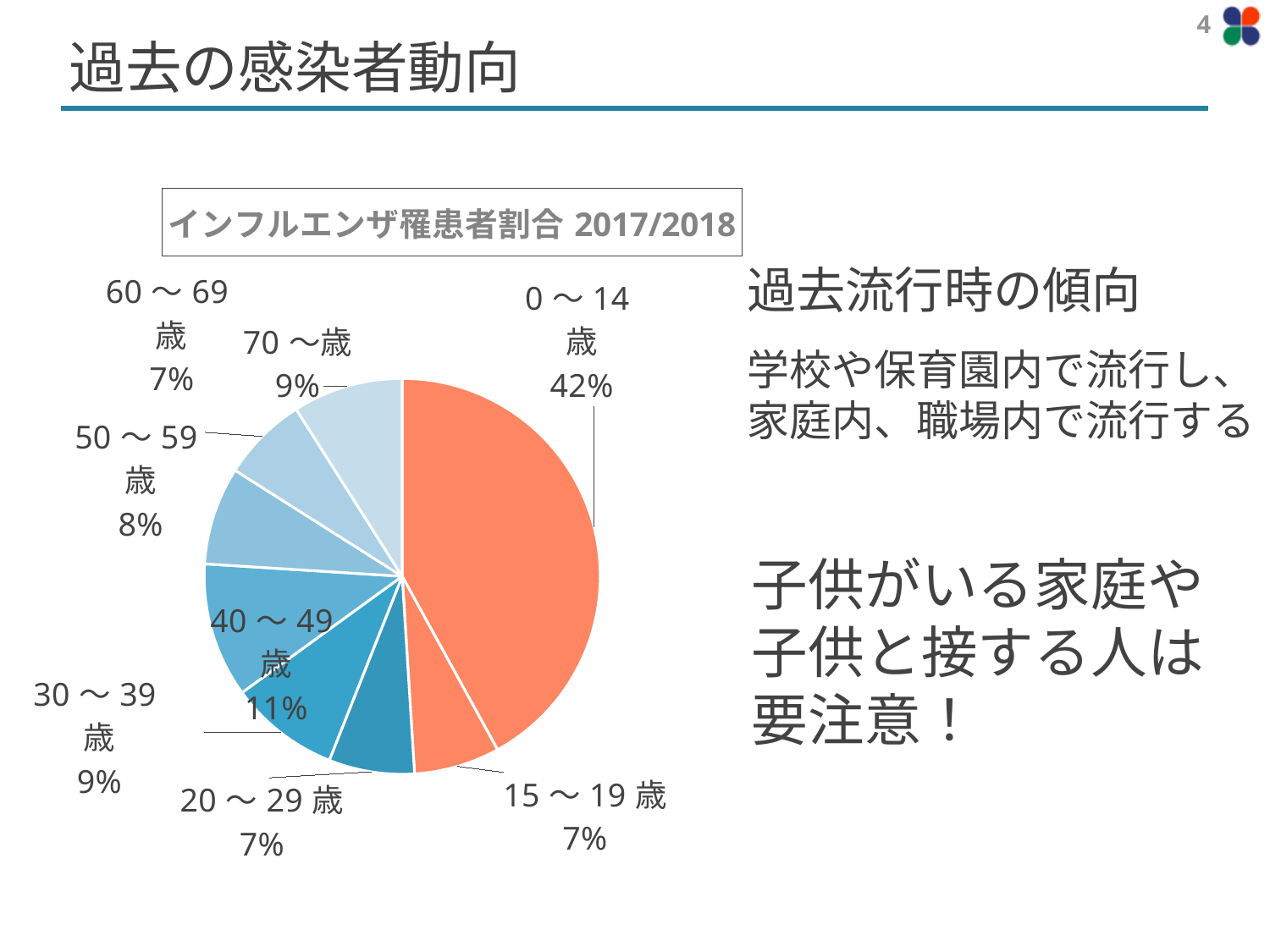
What is the value shown for 40～49歳? 11% How many age-group slices does the pie chart have? 8 What is the title of the chart? インフルエンザ罹患者割合 2017/2018 What share of the pie is the 0～14歳 slice? 42% Which age group has the largest share of the pie? 0～14歳 What kind of chart is shown on the slide? pie chart What is the value shown for 50～59歳? 8% What is the difference between the shares of 40～49歳 and 20～29歳? 4% What is the difference between the shares of 0～14歳 and 40～49歳? 31% Which slice of the pie is coloured orange? 0～14歳 and 15～19歳 Which is larger, the share for 30～39歳 or the share for 50～59歳? 30～39歳 What is the value shown for 70～歳? 9%